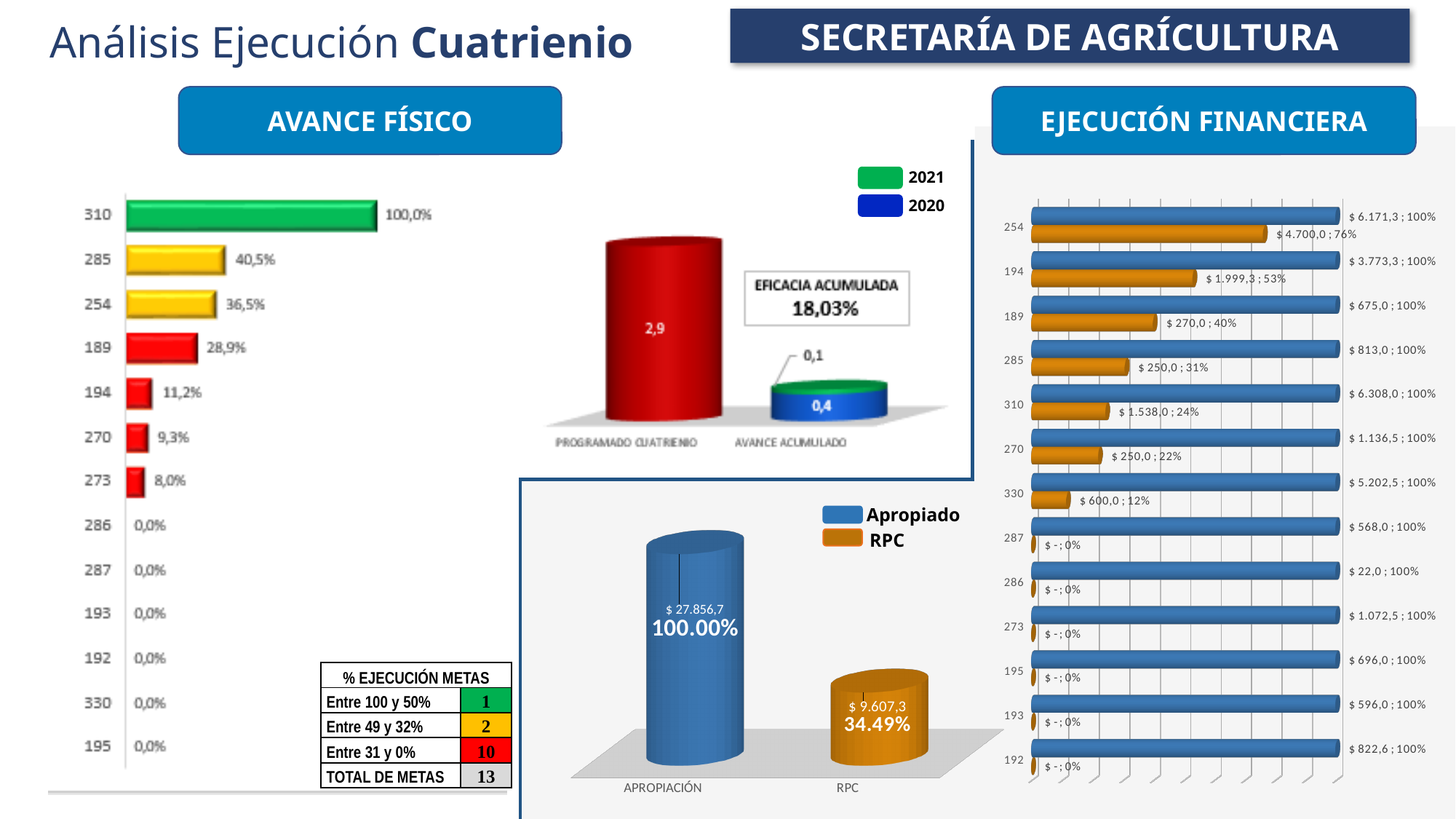
In the Avance Físico bar chart on the left, what is the difference between the values for 254 and 189? 7,6% In the Ejecución Financiera bar chart on the right, which category has the highest Apropiado value? 310 In the Programado Cuatrienio vs Avance Acumulado chart in the middle, how many series does the legend list? 2 In the Avance Físico bar chart on the left, how many categories are plotted? 13 What type of chart is the Ejecución Financiera chart on the right? bar chart In the Apropiación vs RPC chart at the bottom middle, what percentage is shown for RPC? 34.49% In the Programado Cuatrienio vs Avance Acumulado chart in the middle, what is the value for Programado Cuatrienio? 2,9 In the Ejecución Financiera bar chart on the right, what is the RPC value for category 194? $ 1.999,3 ; 53% In the Apropiación vs RPC chart at the bottom middle, what is the value for RPC? $ 9.607,3 In the Avance Físico bar chart on the left, which category has the highest value? 310 In the Avance Físico bar chart on the left, what is the value for category 285? 40,5% In the Avance Físico bar chart on the left, which is larger, the value for 194 or the value for 270? 194